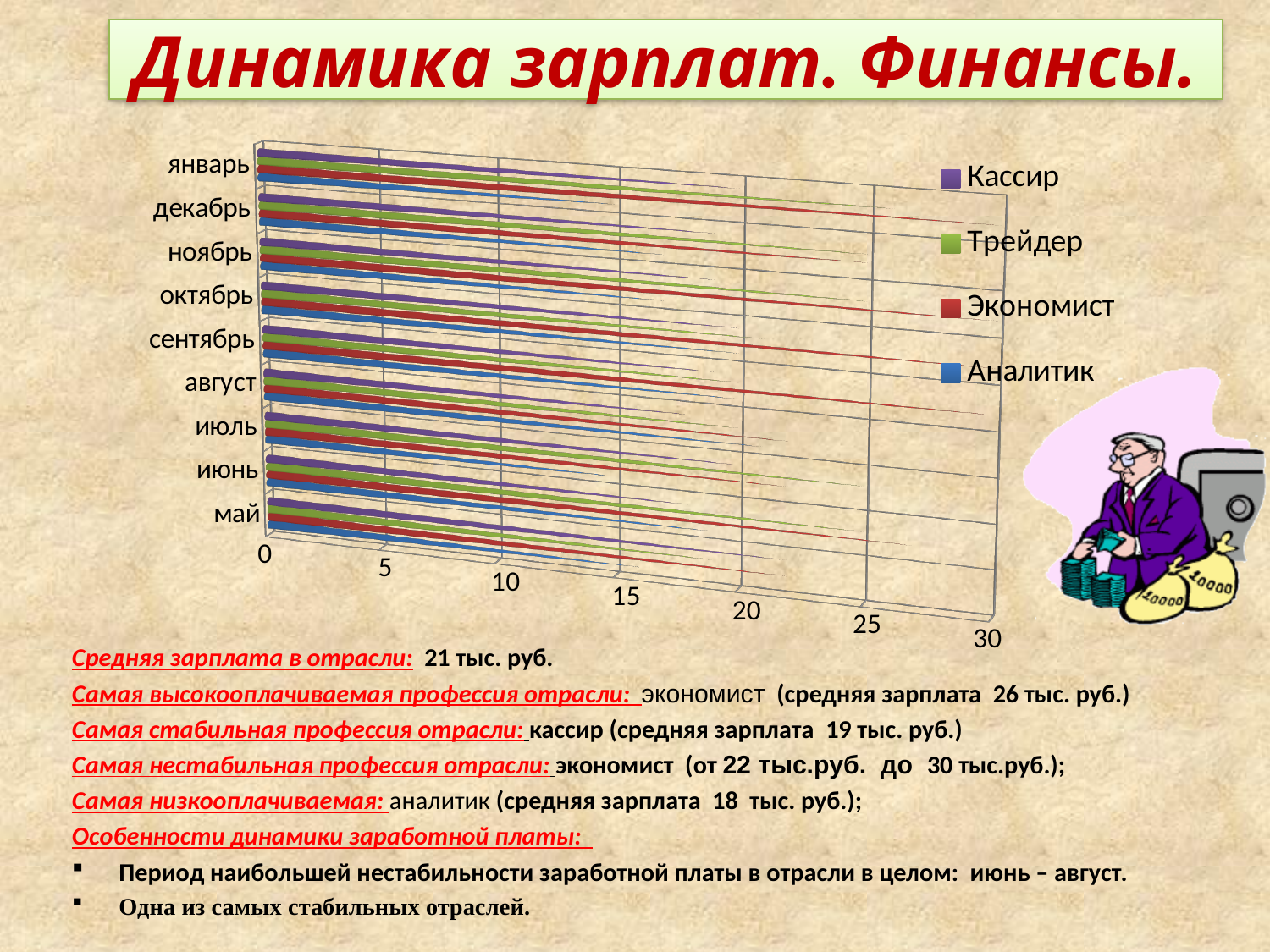
Which is larger in сентябрь: the value for Экономист or the value for Аналитик? Экономист Which month is listed at the top of the chart's vertical axis? январь Which series are listed in the chart legend? Кассир, Трейдер, Экономист, Аналитик Is the value for Аналитик in январь greater or less than 25? less How many series does the chart legend list? 4 How many months (categories) are shown on the chart's vertical axis? 9 Which series has the longest bar for январь? Экономист Is the value for Кассир in май greater or less than 25? less What kind of chart is shown on the slide? bar chart What is the highest value shown on the chart's horizontal axis? 30 Is the value for Экономист in январь greater or less than 20? greater